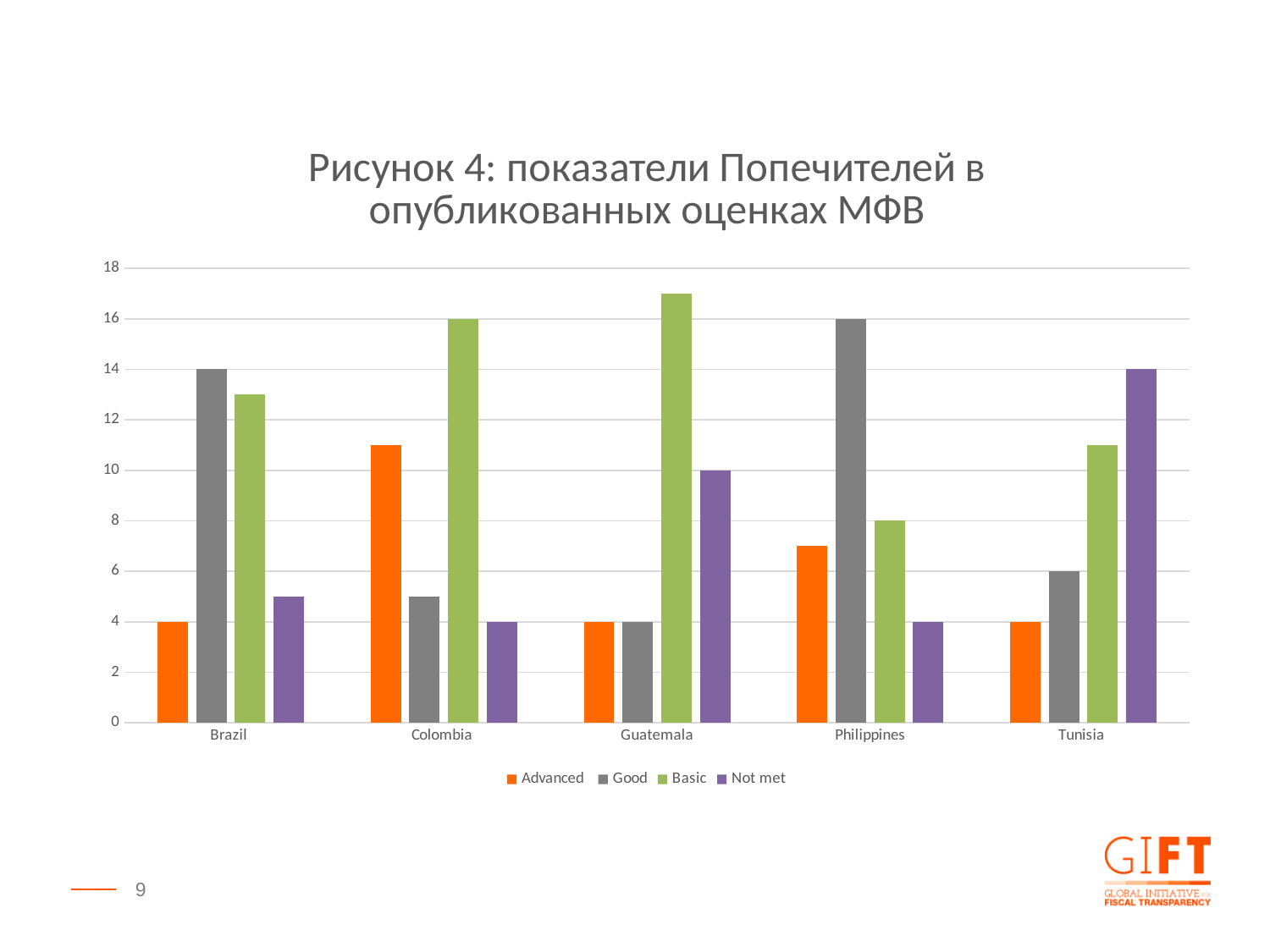
Which country has the highest Advanced value? Colombia Is the Basic value for Brazil greater or less than 12? greater What is the value of the Not met series for Tunisia? 14 What is the value of the Basic series for Philippines? 8 What is the value of the Basic series for Colombia? 16 How many series does the legend list? 4 What is the value of the Good series for Brazil? 14 Which is larger for Tunisia, the Good value or the Not met value? Not met How many countries are shown on the x axis? 5 Which country has the highest Basic value? Guatemala What is the value of the Not met series for Guatemala? 10 What type of chart is shown on the slide? bar chart